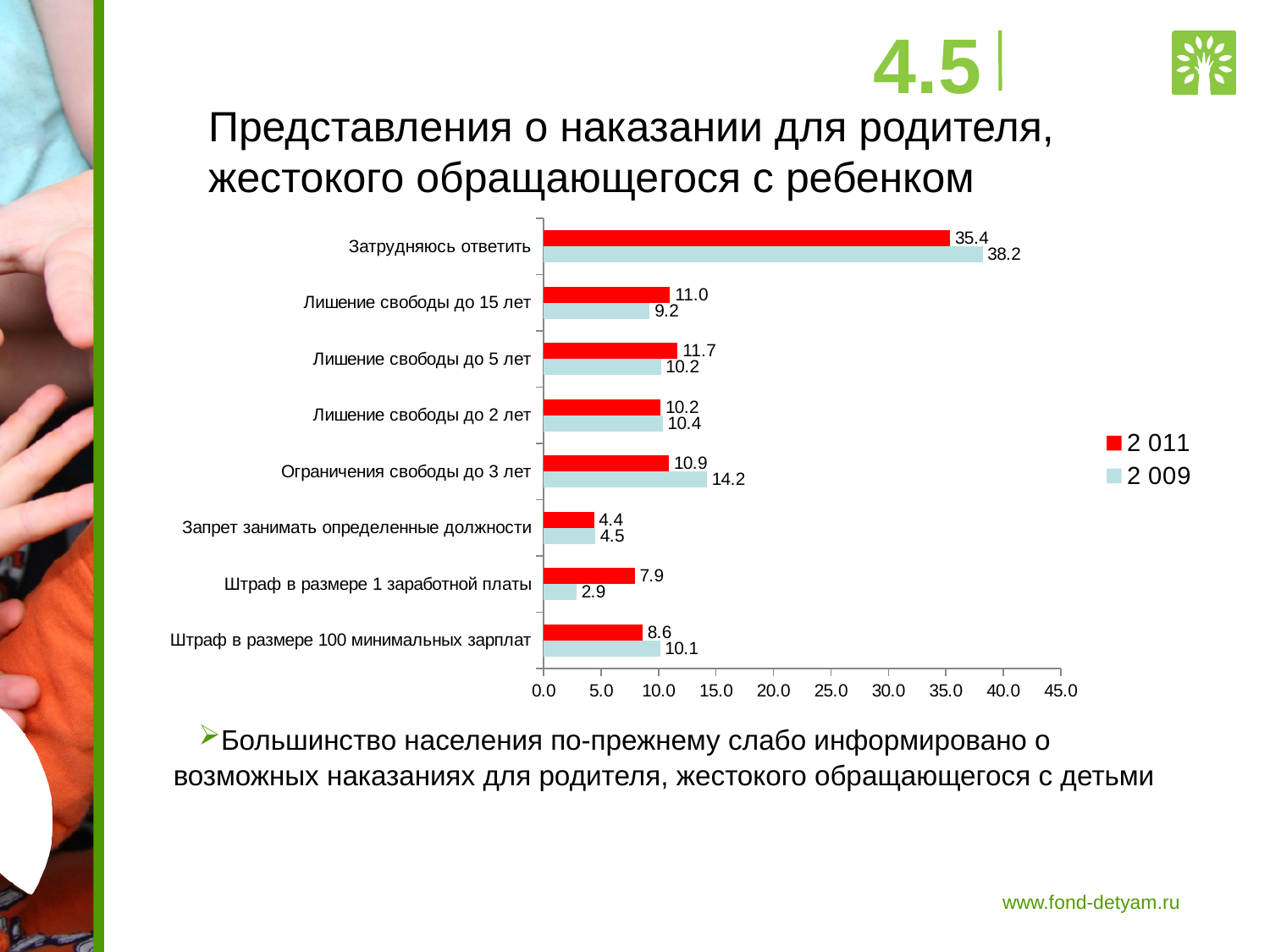
What kind of chart is shown on the slide? Bar chart Which category has the lowest 2 009 value? Штраф в размере 1 заработной платы What is the 2 011 value for "Затрудняюсь ответить"? 35.4 How many categories are shown on the chart? 8 What is the difference between the 2 011 and 2 009 values for "Штраф в размере 1 заработной платы"? 5.0 What is the 2 009 value for "Штраф в размере 1 заработной платы"? 2.9 What is the difference between the 2 009 and 2 011 values for "Затрудняюсь ответить"? 2.8 For "Ограничения свободы до 3 лет", which series has the larger value, 2 011 or 2 009? 2 009 Which category has the highest 2 011 value? Затрудняюсь ответить What is the 2 009 value for "Ограничения свободы до 3 лет"? 14.2 How many series does the legend list? 2 Is the 2 011 value for "Затрудняюсь ответить" greater or less than 30.0? greater